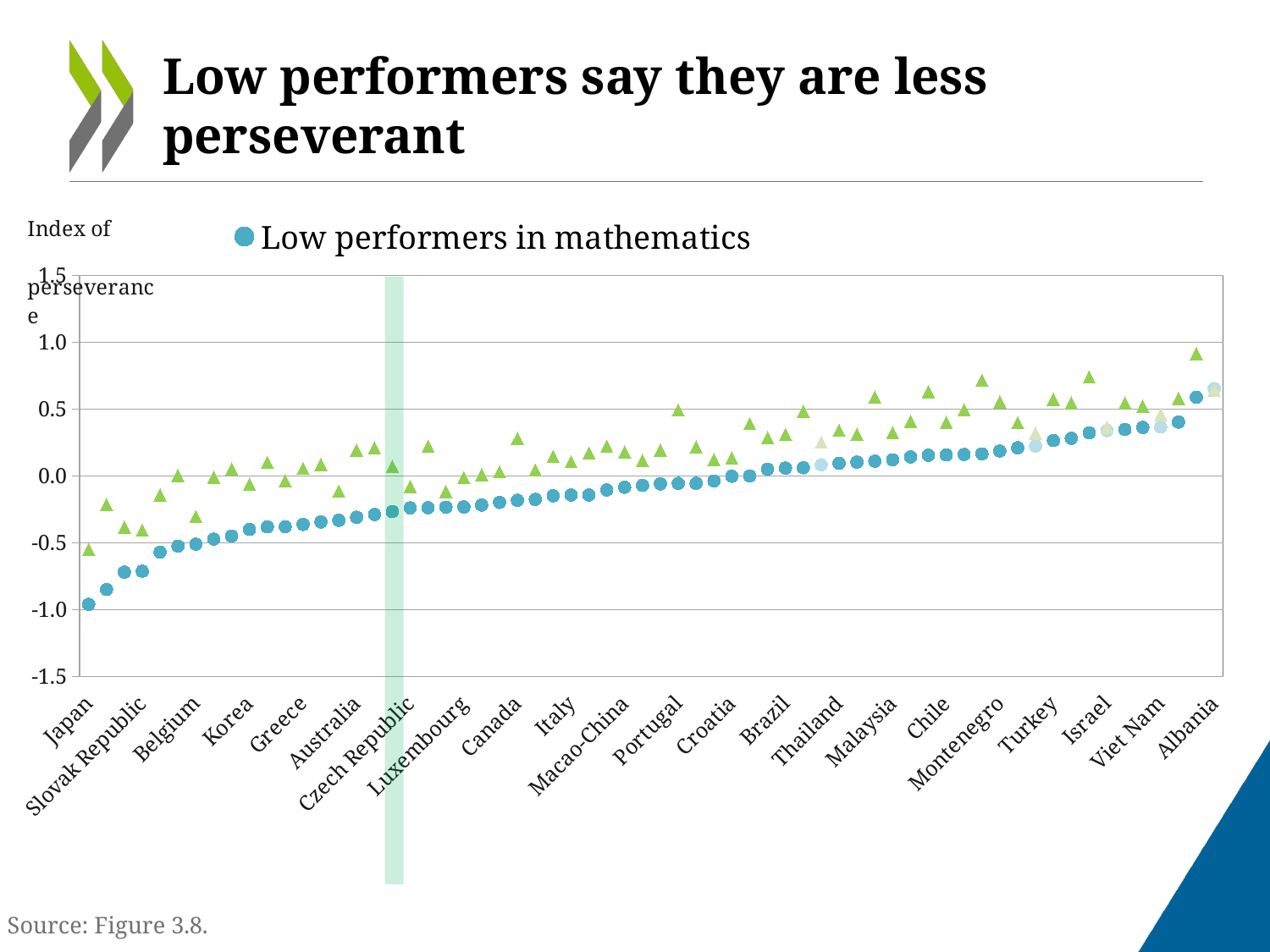
Which country has the lowest value for low performers in mathematics? Japan Is the value for low performers in mathematics in Turkey greater or less than 0.0? greater What series does the legend list? Low performers in mathematics What kind of chart is shown on the slide? Scatter chart Is the value for low performers in mathematics in Albania greater or less than 0.5? greater Is the value for low performers in mathematics in Japan greater or less than -0.5? less Do the values for low performers in mathematics rise or fall from left to right along the x axis? Rise Which country has the highest value for low performers in mathematics? Albania How many series does the legend list? 1 Which has the larger value for low performers in mathematics, Japan or Albania? Albania